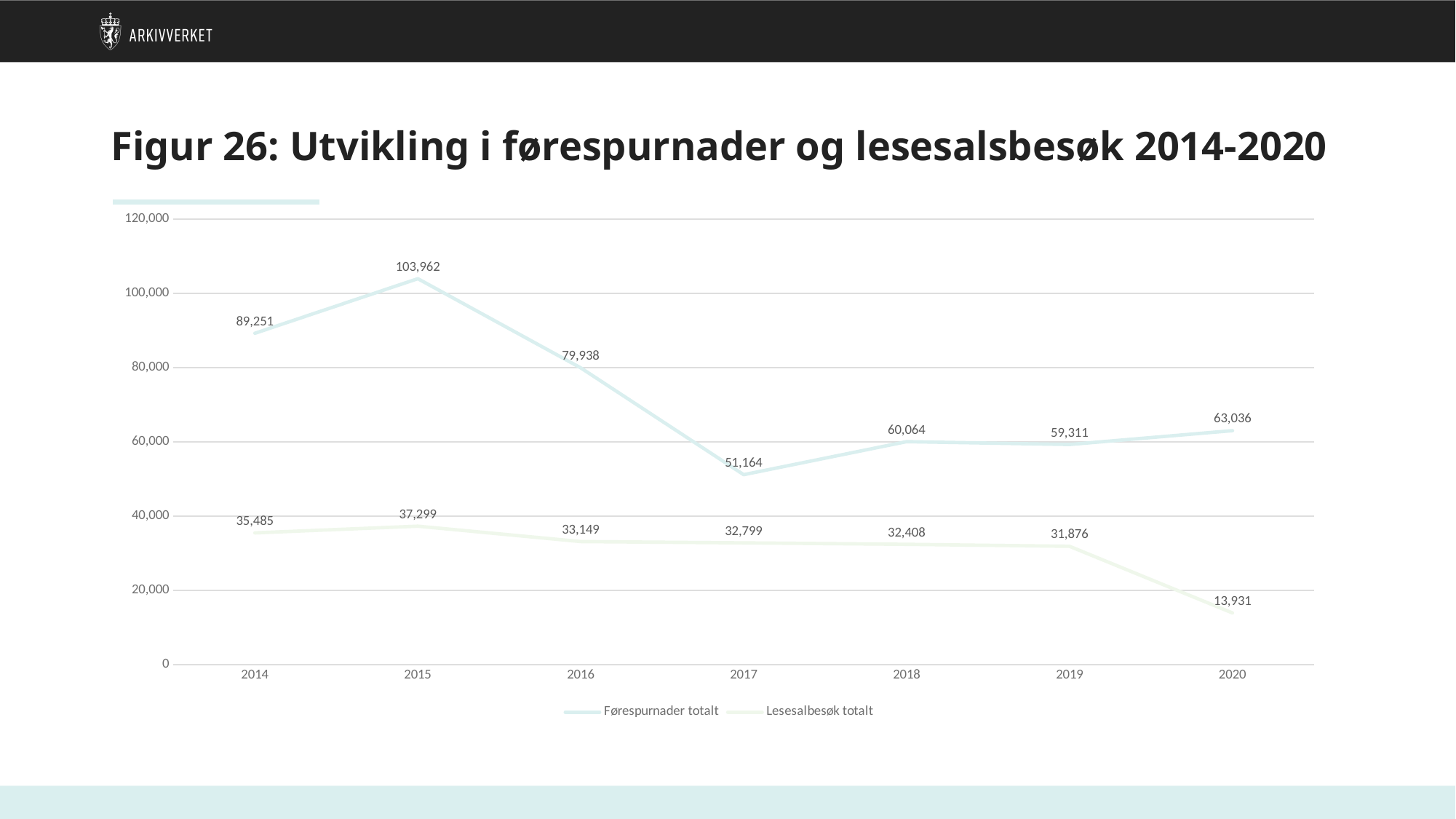
What is the difference between Førespurnader totalt in 2014 and 2015? 14,711 What is the value of Førespurnader totalt in 2015? 103,962 In which year is Førespurnader totalt highest? 2015 What is the value of Førespurnader totalt in 2017? 51,164 What kind of chart is shown on the slide? line chart Does Lesesalbesøk totalt rise or fall from 2015 to 2020? fall In which year is Lesesalbesøk totalt lowest? 2020 Is the value of Førespurnader totalt in 2016 greater or less than 80,000? less Which is larger: Lesesalbesøk totalt in 2014 or in 2015? 2015 How many series does the legend list? 2 What is the value of Lesesalbesøk totalt in 2020? 13,931 How many years are shown on the x axis? 7